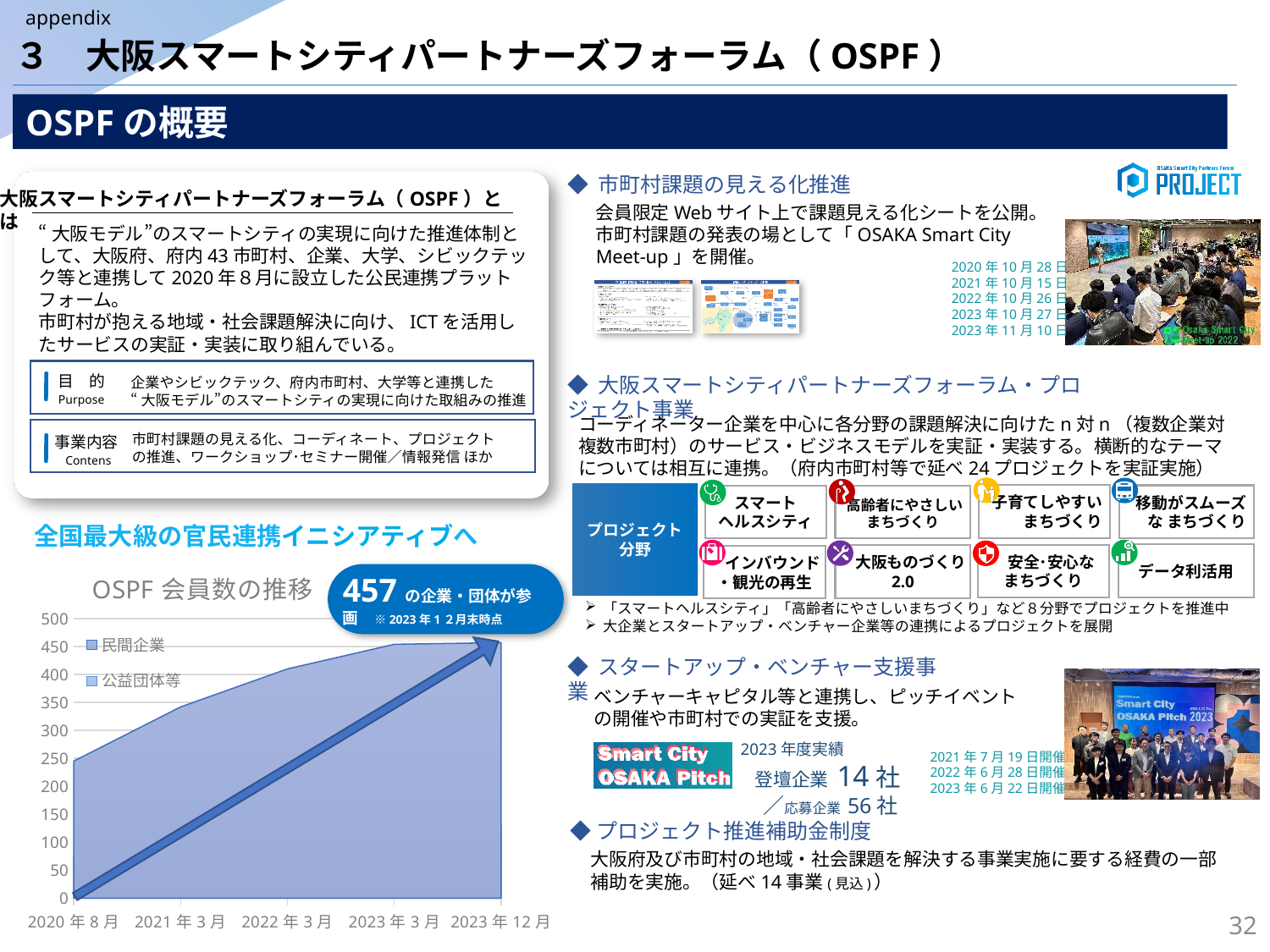
What are the two legend entries in the "OSPF 会員数の推移" chart? 民間企業 and 公益団体等 In the "OSPF 会員数の推移" chart, is the total value for 2023年12月 greater or less than 400? greater In the "OSPF 会員数の推移" chart, which time point has the highest total member count? 2023年12月 In the "OSPF 会員数の推移" chart, which time point has the lowest total member count? 2020年8月 In the "OSPF 会員数の推移" chart, is the total value for 2021年3月 greater or less than 300? greater How many time points are shown on the x axis of the "OSPF 会員数の推移" chart? 5 What is the highest tick value shown on the y axis of the "OSPF 会員数の推移" chart? 500 Do the total member numbers in the "OSPF 会員数の推移" chart rise or fall from 2020年8月 to 2023年12月? Rise According to the callout on the "OSPF 会員数の推移" chart, how many companies and organizations participate as of the end of 2023年12月? 457 What kind of chart is the "OSPF 会員数の推移" chart? Area chart How many series does the legend of the "OSPF 会員数の推移" chart list? 2